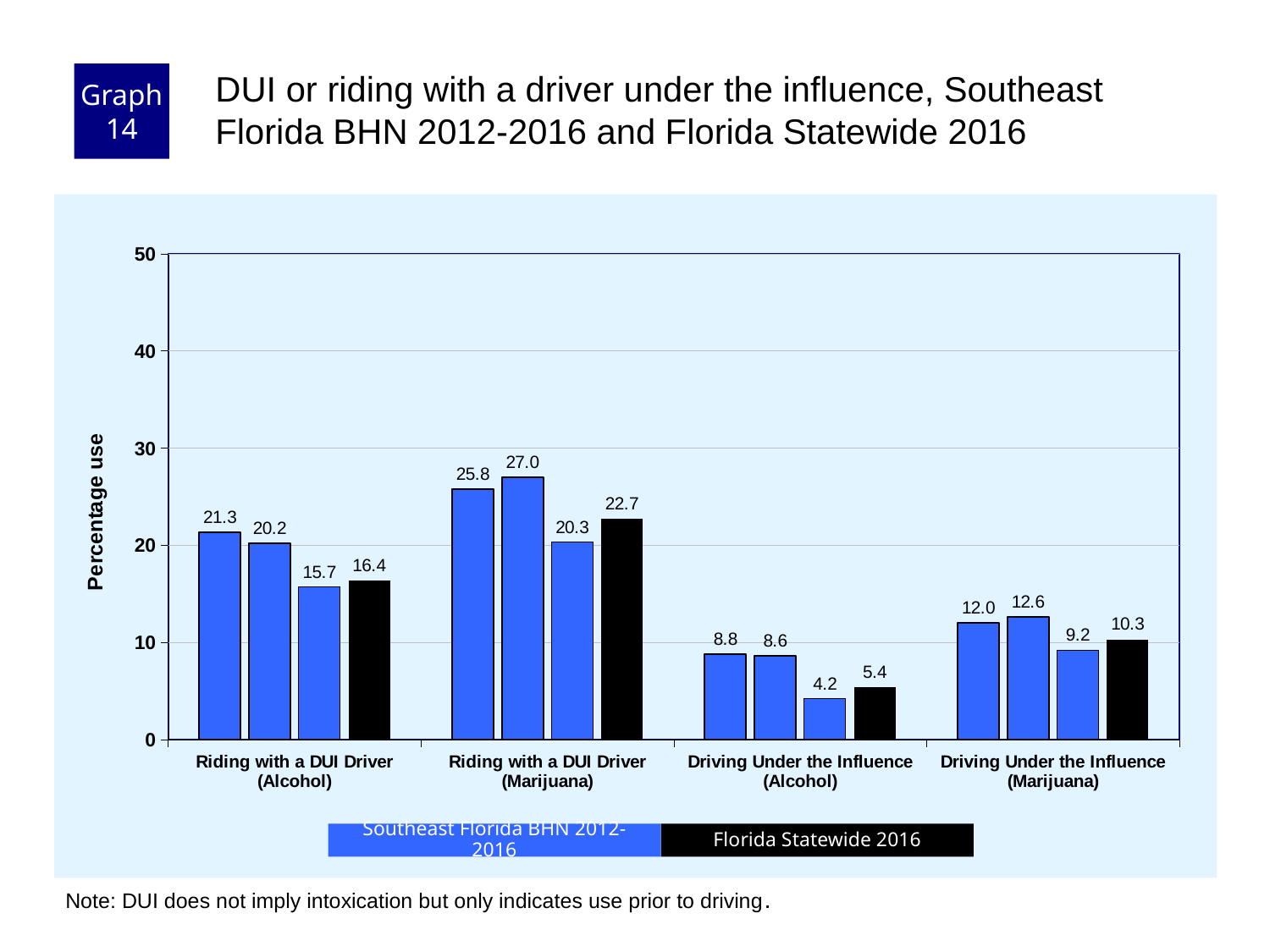
How many series does the legend list? 2 What is the value of the tallest bar in the Driving Under the Influence (Marijuana) group? 12.6 What is the lowest value shown on the chart? 4.2 What is the title of the y axis? Percentage use Is the Florida Statewide 2016 value for Riding with a DUI Driver (Marijuana) greater or less than 20? greater What is the Florida Statewide 2016 value for Driving Under the Influence (Alcohol)? 5.4 Which has the larger Florida Statewide 2016 value: Riding with a DUI Driver (Alcohol) or Riding with a DUI Driver (Marijuana)? Riding with a DUI Driver (Marijuana) How many categories are shown on the x axis? 4 What is the Florida Statewide 2016 value for Riding with a DUI Driver (Marijuana)? 22.7 What is the difference between the Florida Statewide 2016 values for Riding with a DUI Driver (Alcohol) and Driving Under the Influence (Alcohol)? 11.0 Which category contains the tallest bar on the chart? Riding with a DUI Driver (Marijuana) What kind of chart is shown on the slide? bar chart